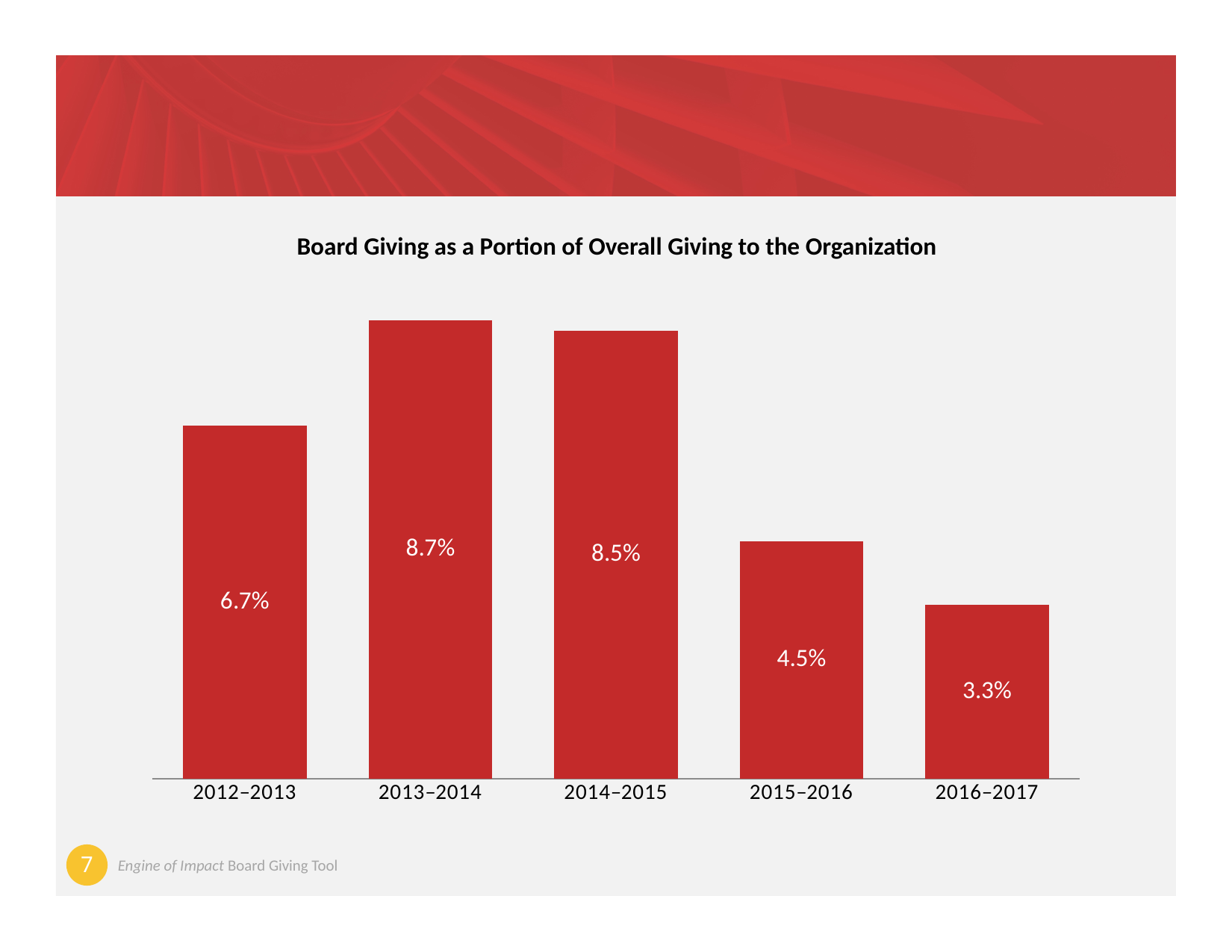
Which period has the lowest value? 2016–2017 What is the difference between the values for 2014–2015 and 2015–2016? 4.0% What is the value for 2012–2013? 6.7% What is the value for 2015–2016? 4.5% What is the difference between the values for 2013–2014 and 2016–2017? 5.4% Which period has the highest value? 2013–2014 What is the value for 2016–2017? 3.3% Which is larger, the value for 2012–2013 or the value for 2015–2016? 2012–2013 What is the value for 2013–2014? 8.7% What is the title of the chart? Board Giving as a Portion of Overall Giving to the Organization What kind of chart is shown on the slide? Bar chart How many periods are shown on the chart? 5